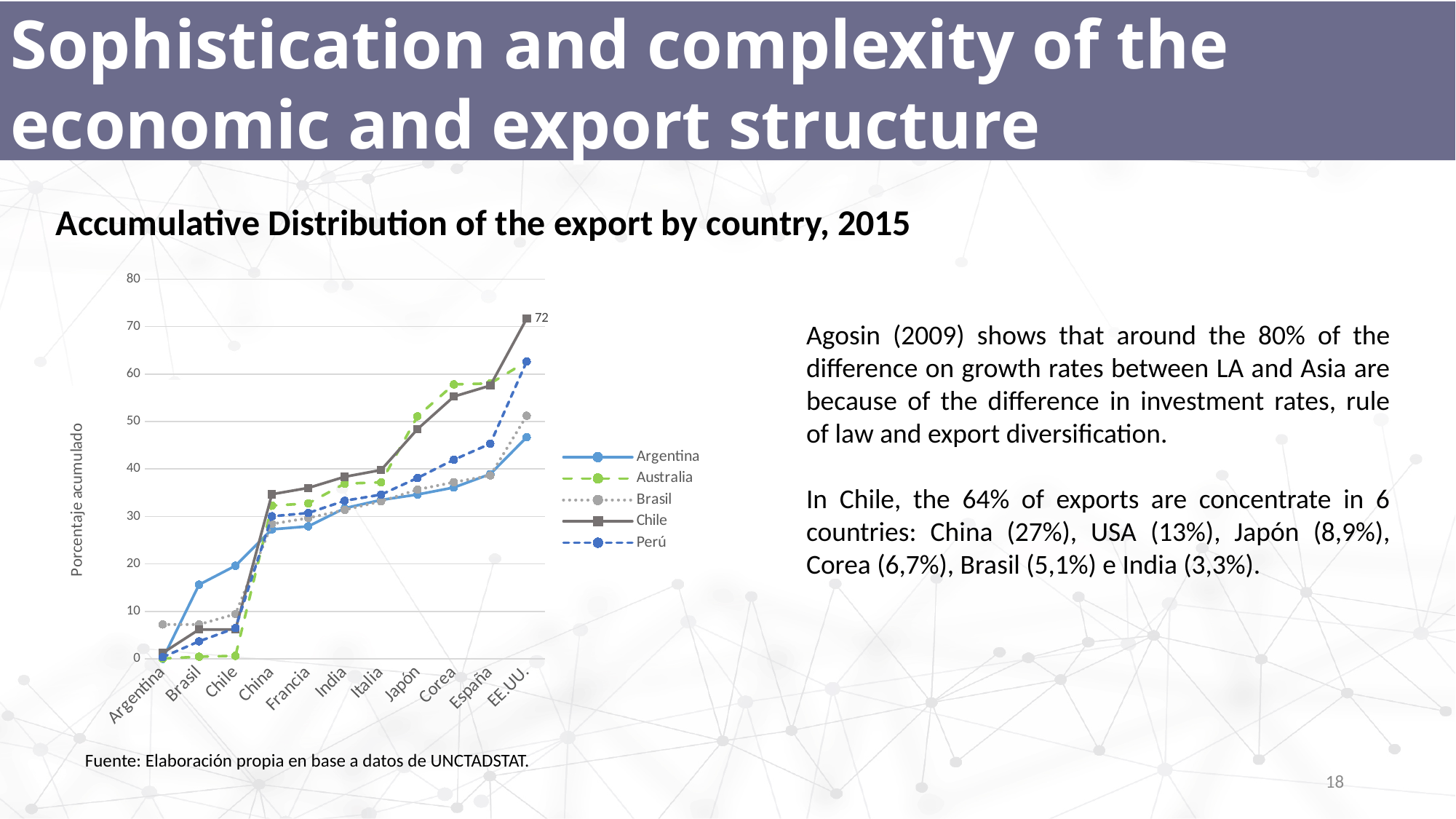
How many categories are shown along the x axis of the chart? 11 Do the values of the Chile series rise or fall along the x axis? rise Which series has the highest value at EE.UU.? Chile What kind of chart is shown on the slide? line chart At the Brasil category, which series has the larger value, Argentina or Chile? Argentina Is the value of the Chile series at China greater or less than 30? greater What is the label of the y axis of the chart? Porcentaje acumulado Is the value of the Argentina series at EE.UU. greater or less than 50? less What is the value of the Chile series at EE.UU.? 72 At the Japón category, which series has the larger value, Chile or Argentina? Chile How many series does the chart legend list? 5 Is the value of the Australia series at Corea greater or less than 50? greater